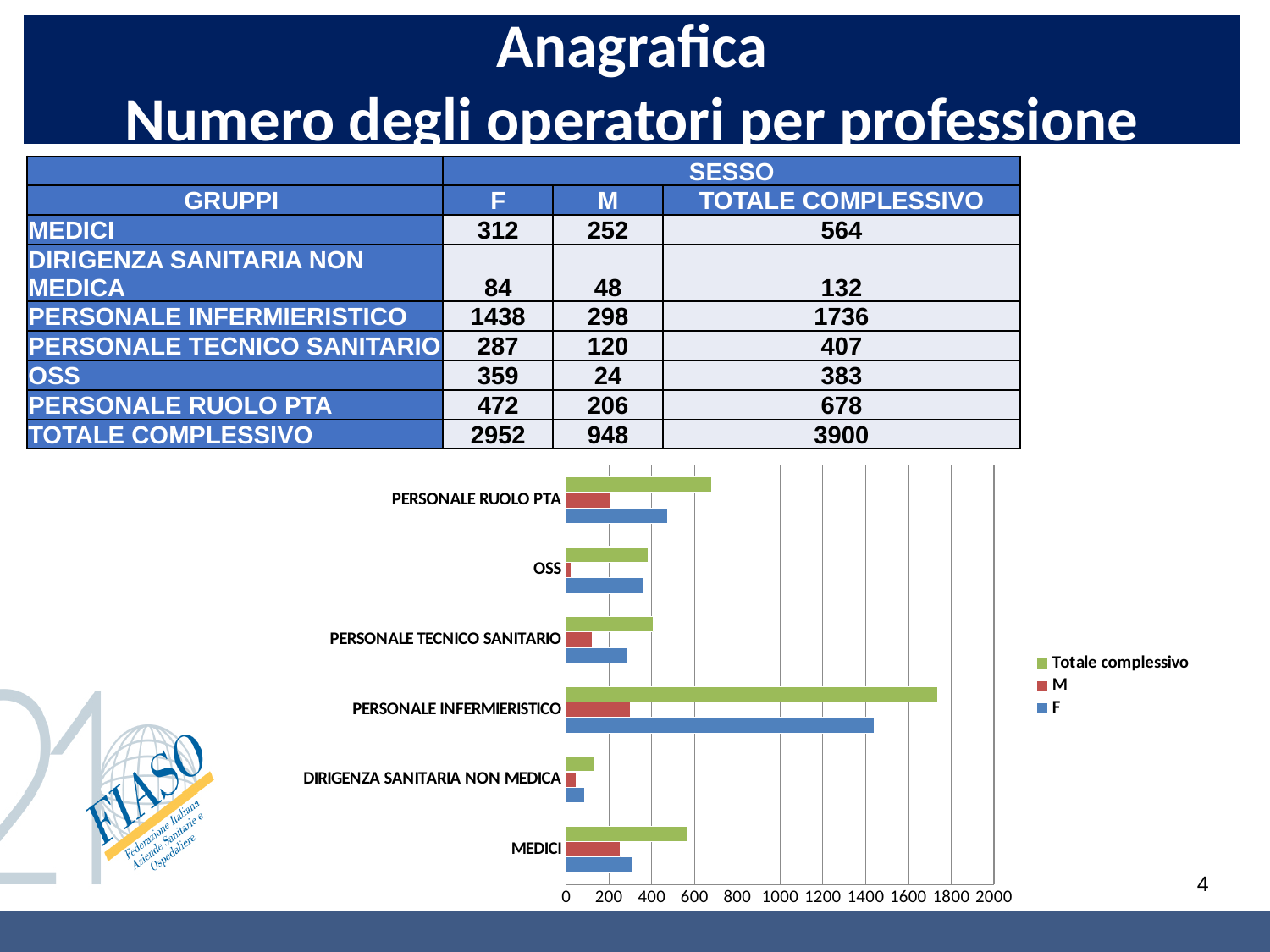
Which group has the highest Totale complessivo bar on the chart? PERSONALE INFERMIERISTICO Which group has the smallest M bar on the chart? OSS What kind of chart is shown on the slide? bar chart Is the F value for PERSONALE INFERMIERISTICO greater or less than 1200? greater Is the Totale complessivo value for MEDICI greater or less than 400? greater What is the M value for PERSONALE RUOLO PTA? 206 What is the difference between the Totale complessivo of PERSONALE RUOLO PTA and that of OSS? 295 How many series does the chart legend list? 3 Which group has the lowest Totale complessivo bar on the chart? DIRIGENZA SANITARIA NON MEDICA What is the F value for MEDICI? 312 For OSS, which is larger, the F bar or the M bar? F How many professional groups are plotted on the chart? 6